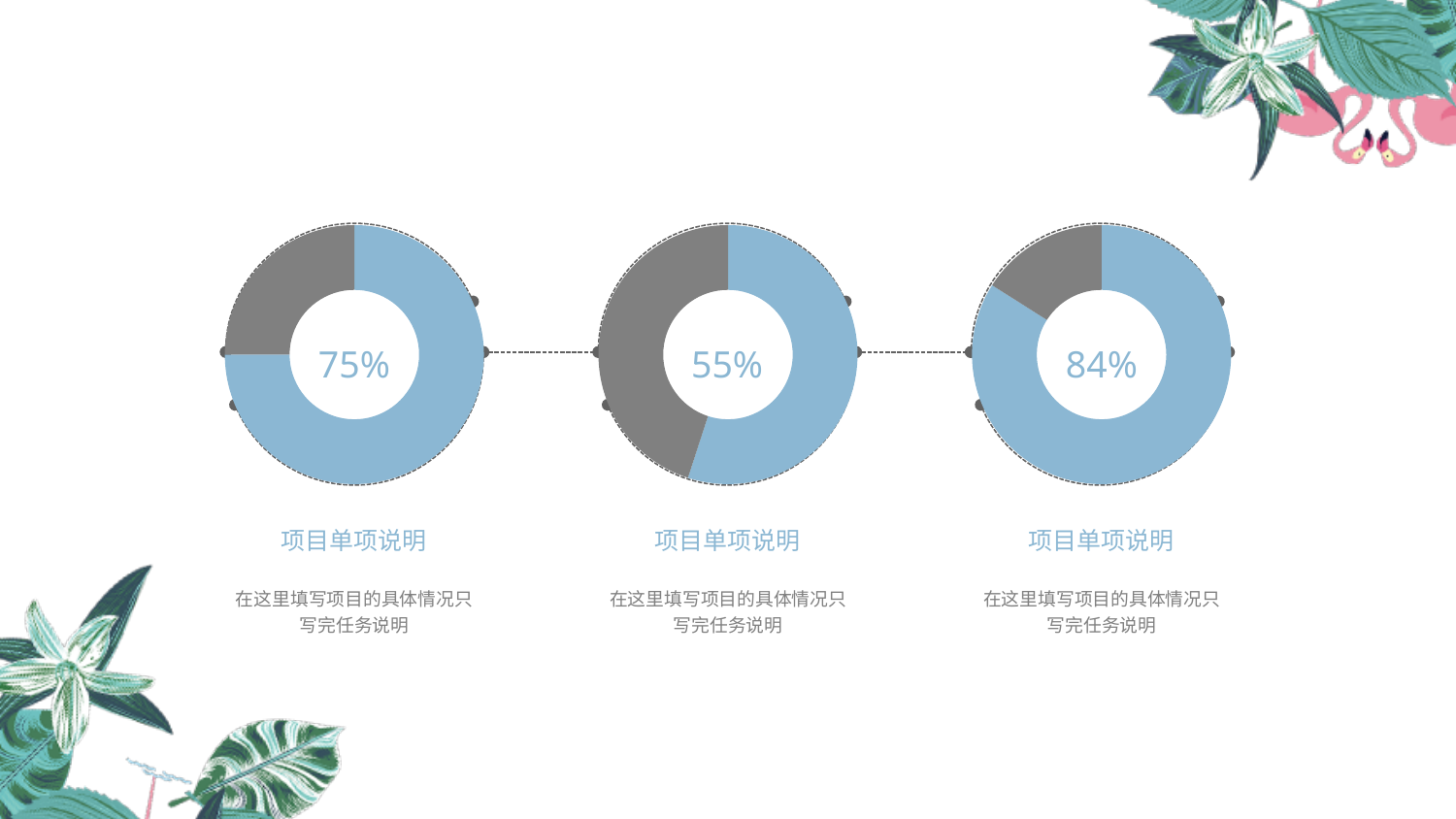
Is the percentage in the left donut chart larger or smaller than the percentage in the middle donut chart? larger What is the difference in percentage points between the left donut chart (75%) and the middle donut chart (55%)? 20 What kind of chart is used to display the percentages on this slide? donut chart What percentage is shown in the center of the left donut chart? 75% What is the difference in percentage points between the right donut chart (84%) and the left donut chart (75%)? 9 What colour is used for the filled (percentage) portion of each donut chart? blue What percentage is shown in the center of the right donut chart? 84% In the middle donut chart, is the blue portion greater or less than 50%? greater Which of the three donut charts shows the lowest percentage: left, middle, or right? middle How many donut charts are shown on the slide? 3 Which of the three donut charts shows the highest percentage: left, middle, or right? right What percentage is shown in the center of the middle donut chart? 55%